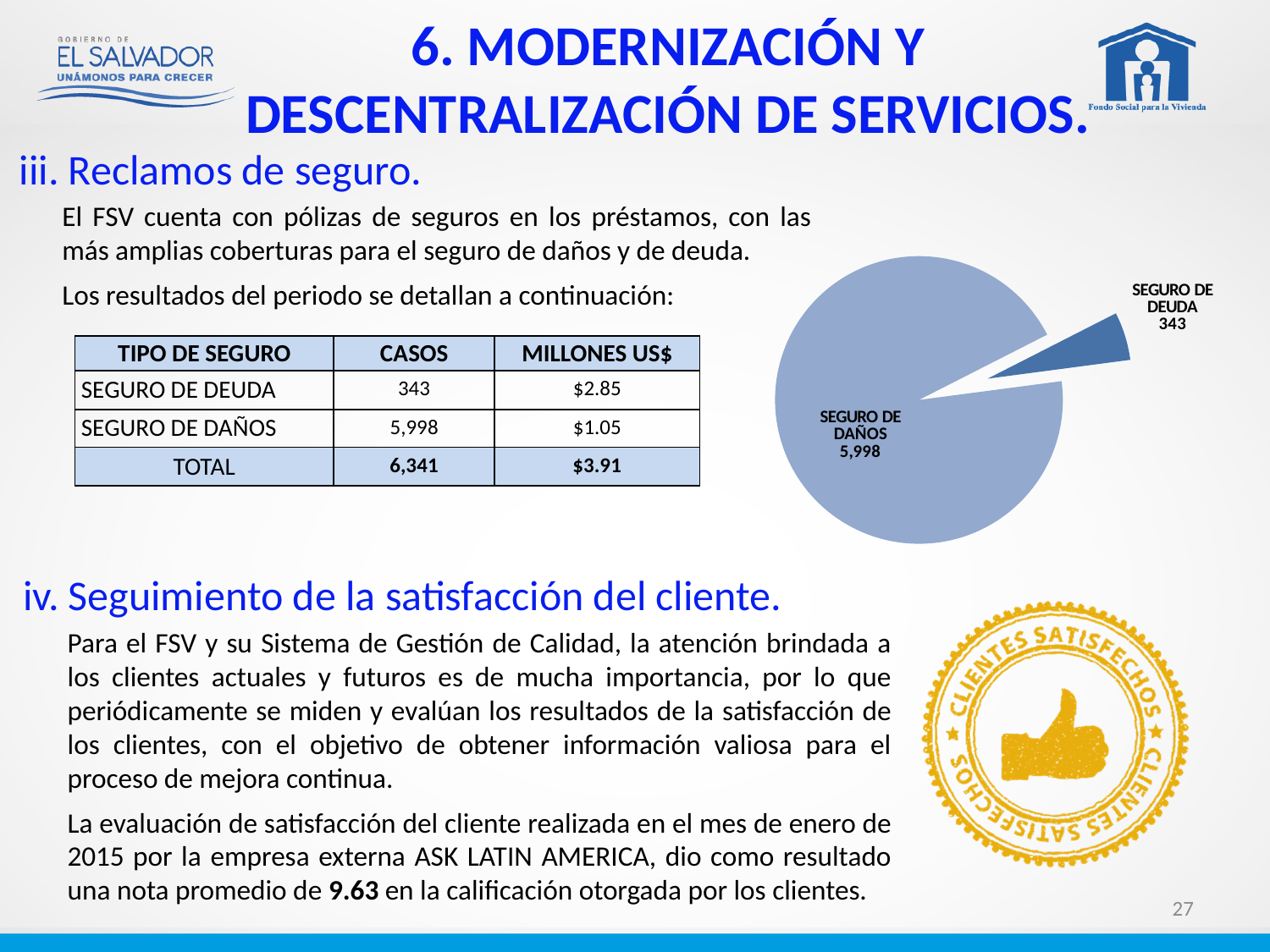
What is the value shown for SEGURO DE DAÑOS in the pie chart? 5,998 Which is larger in the pie chart, SEGURO DE DEUDA or SEGURO DE DAÑOS? SEGURO DE DAÑOS What is the difference between the values for SEGURO DE DAÑOS and SEGURO DE DEUDA in the pie chart? 5,655 Which slice of the pie chart is drawn pulled out from the rest of the pie? SEGURO DE DEUDA How many slices does the pie chart have? 2 What is the total of the two values shown in the pie chart? 6,341 What share of the pie chart does SEGURO DE DAÑOS represent? 94.6% What kind of chart is shown on the slide? pie chart Which slice of the pie chart is the smallest? SEGURO DE DEUDA What is the value shown for SEGURO DE DEUDA in the pie chart? 343 Which slice of the pie chart is the largest? SEGURO DE DAÑOS What share of the pie chart does SEGURO DE DEUDA represent? 5.4%